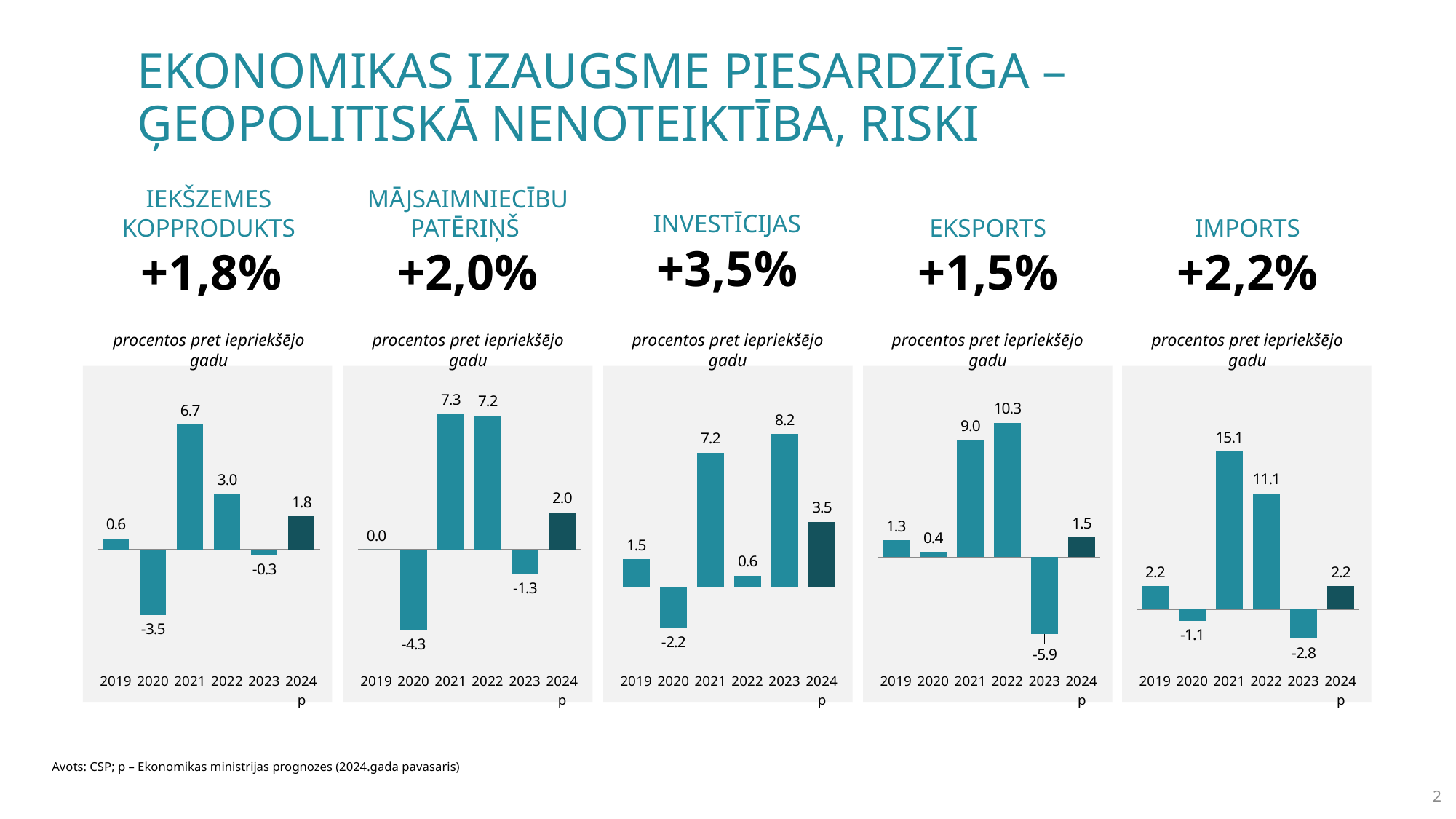
In the IMPORTS chart, what is the difference between the 2021 and 2022 values? 4.0 In the IEKŠZEMES KOPPRODUKTS chart, which year has the lowest value? 2020 In the INVESTĪCIJAS chart, which year has the highest value? 2023 In the INVESTĪCIJAS chart, what is the value for 2024 p? 3.5 In the IEKŠZEMES KOPPRODUKTS chart, what is the value for 2021? 6.7 In the IMPORTS chart, what is the value for 2021? 15.1 In the EKSPORTS chart, is the value for 2022 larger than the value for 2021? Yes What type of chart is the IMPORTS chart? Bar chart In the EKSPORTS chart, what is the value for 2023? -5.9 In the MĀJSAIMNIECĪBU PATĒRIŅŠ chart, what is the value for 2020? -4.3 How many years are shown on the x axis of the EKSPORTS chart? 6 In the MĀJSAIMNIECĪBU PATĒRIŅŠ chart, what is the difference between the 2021 and 2022 values? 0.1